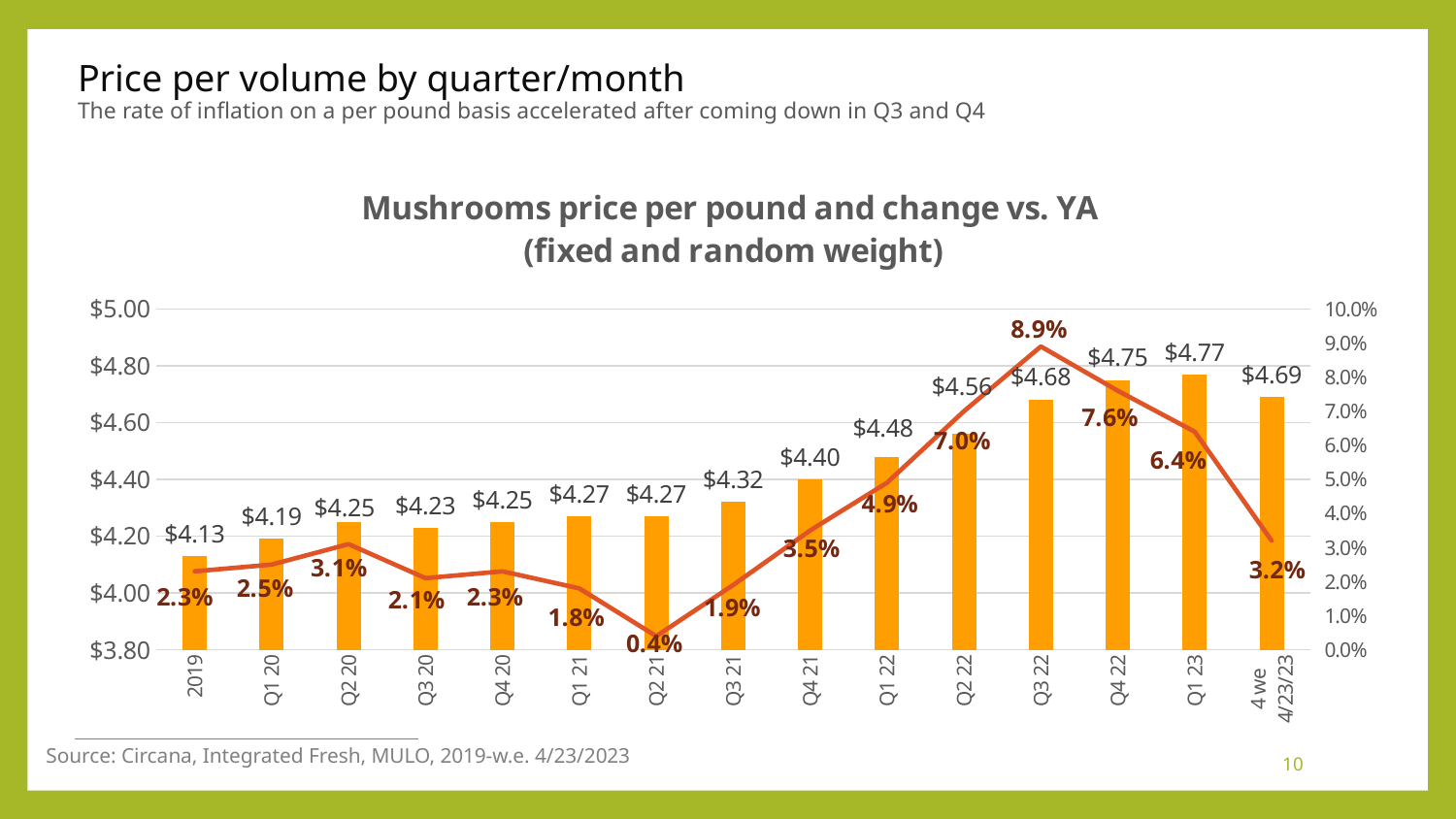
What kind of chart is shown? Bar chart with a line Which period has the highest price per pound? Q1 23 Which period has the lowest price per pound? 2019 What is the change vs. YA shown for the 4 weeks ending 4/23/23? 3.2% Which has the higher price per pound, Q4 22 or the 4 weeks ending 4/23/23? Q4 22 What is the mushrooms price per pound shown for Q3 22? $4.68 Which period has the highest change vs. YA? Q3 22 How many periods are plotted along the x axis? 15 Which period has the lowest change vs. YA? Q2 21 What is the change vs. YA shown for Q2 21? 0.4% What is the difference in price per pound between Q1 23 and 2019? $0.64 Does the price per pound rise or fall from Q4 21 to Q1 23? Rise